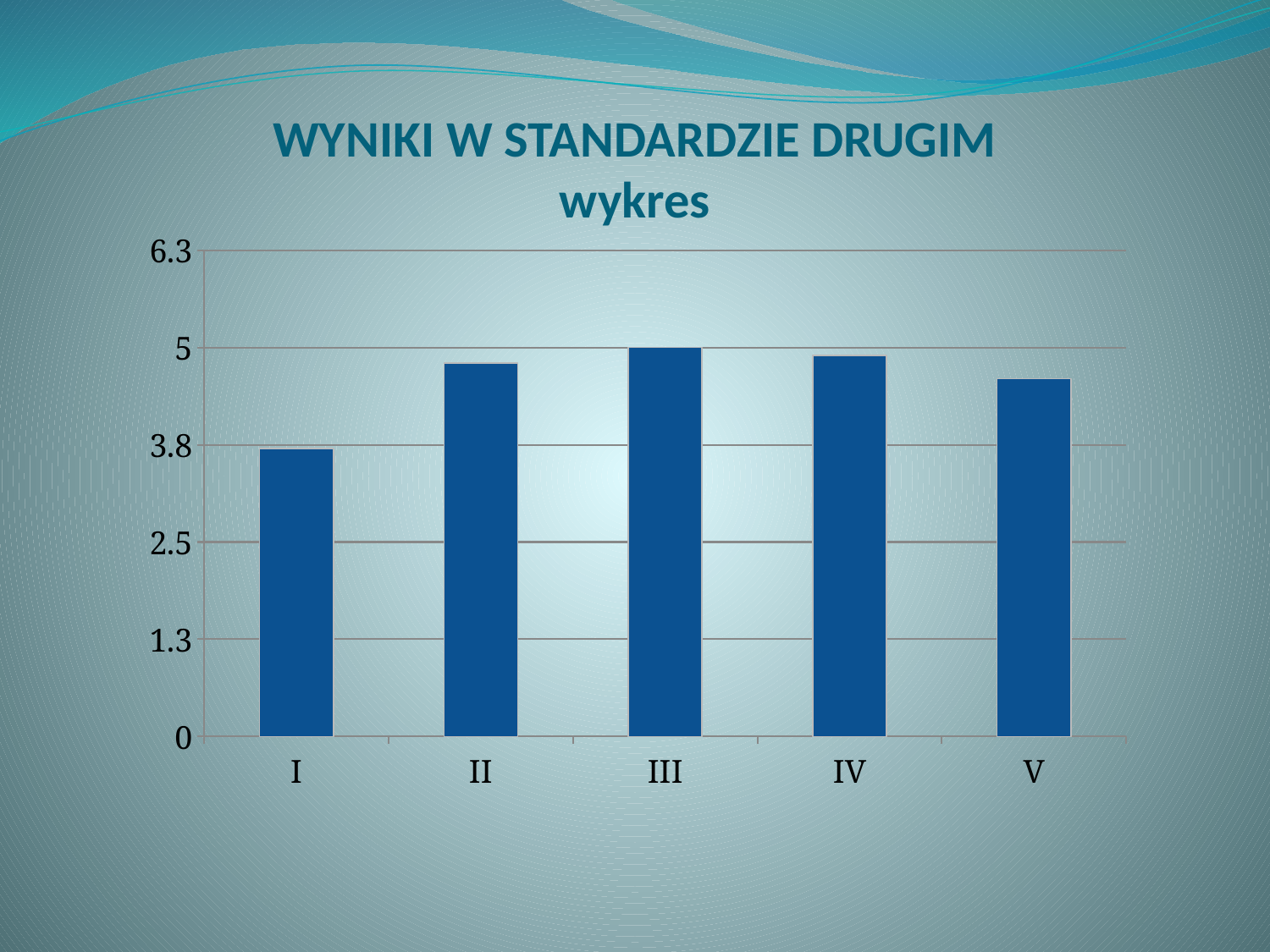
What is the title of the chart? WYNIKI W STANDARDZIE DRUGIM wykres Which is larger, the value for I or the value for II? II Is the value for I greater or less than 2.5? greater Is the value for V greater or less than 5? less Which is larger, the value for III or the value for V? III Which category has the lowest bar in the chart? I Which is larger, the value for I or the value for V? V What is the highest value labelled on the y axis of the chart? 6.3 Do the values rise or fall from category I to category III? rise Is the value for II greater or less than 3.8? greater How many categories are shown on the x axis of the chart? 5 What kind of chart is shown on the slide? bar chart